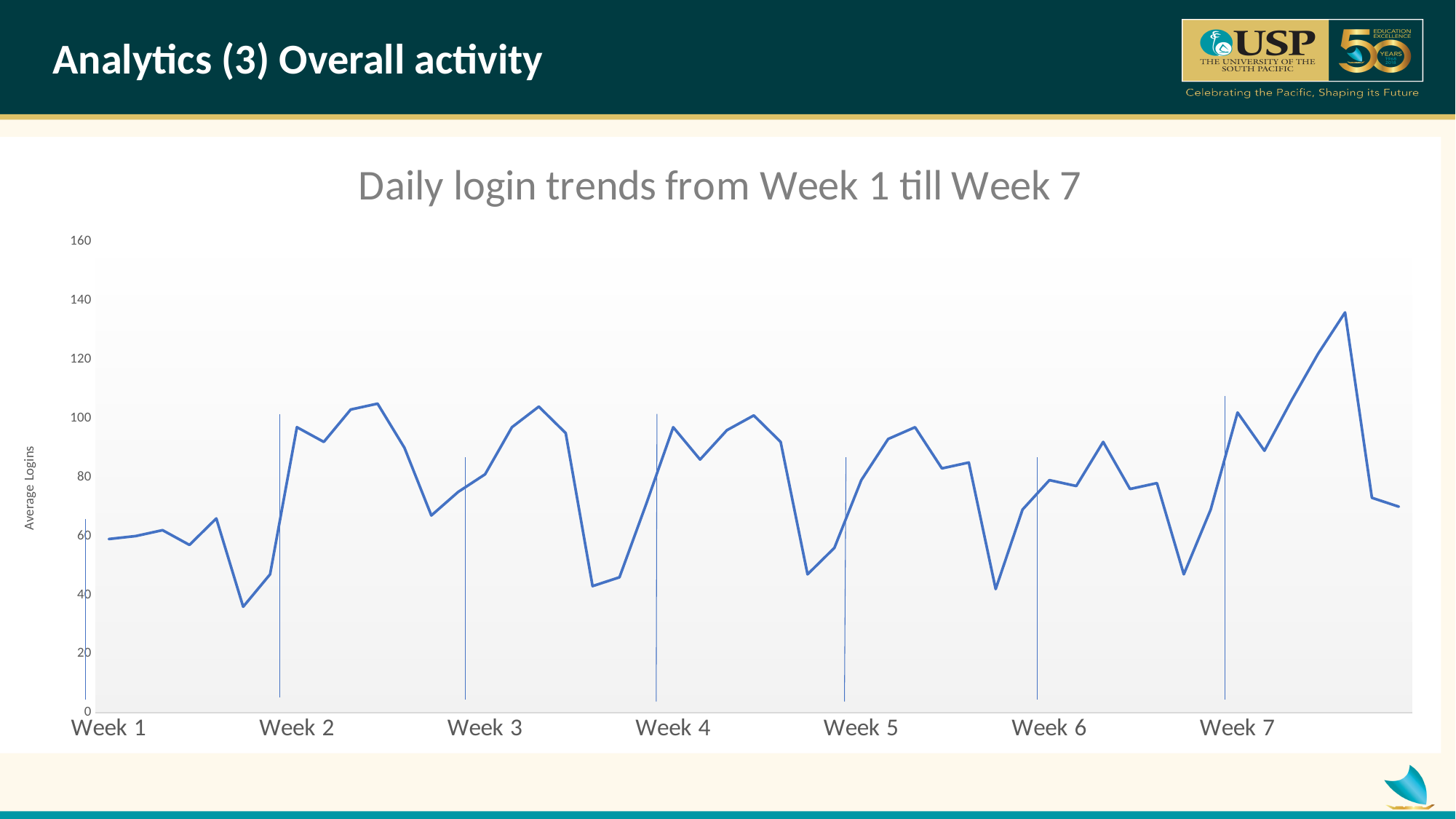
Is the first point of the line in Week 1 greater or less than 40? greater How many week labels are shown along the x axis? 7 Which is higher: the peak of the line in Week 7 or the peak of the line in Week 3? Week 7 Is the highest point of the line in Week 7 greater or less than 120? greater What is the label on the vertical axis of the chart? Average Logins Is the highest point of the line in Week 2 greater or less than 80? greater What is the title of the chart? Daily login trends from Week 1 till Week 7 What kind of chart is shown on the slide? line chart In which week does the line reach its highest point? Week 7 What is the highest value shown on the vertical axis? 160